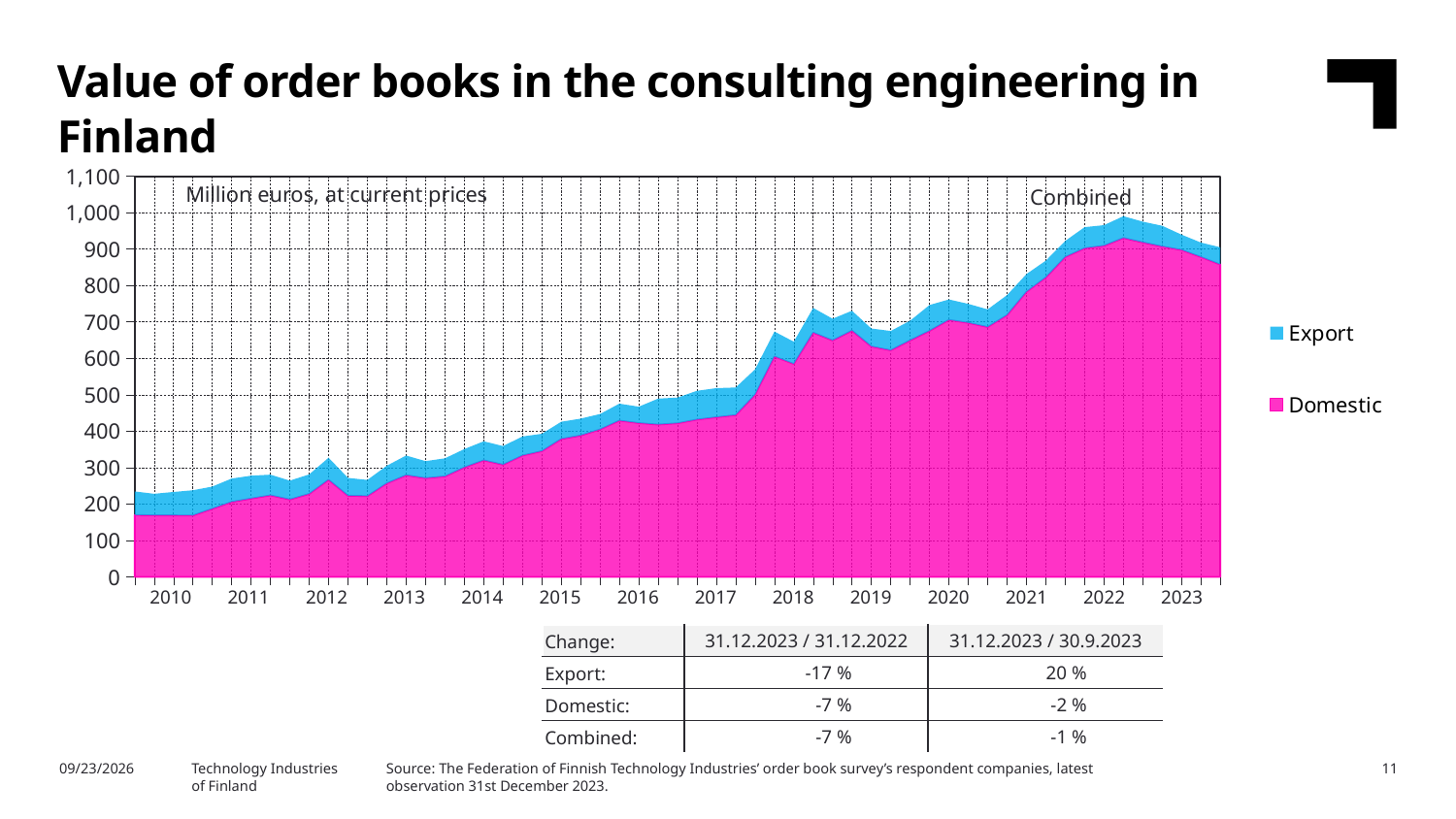
How many years are labelled on the x axis of the chart? 14 Is the Domestic value at the start of 2010 greater or less than 200? less What kind of chart is shown on the slide? Stacked area chart Do the combined order book values generally rise or fall from 2010 to 2022? Rise Which two series are listed in the chart legend? Export and Domestic Is the combined value at the start of 2016 greater or less than 400? greater Is the combined value at the start of 2010 greater or less than 300? less How many series does the chart legend list? 2 In which year does the combined value of order books reach its highest point? 2022 According to the change table below the chart, what is the Export change for 31.12.2023 / 31.12.2022? -17 % What unit is stated in the chart for the values plotted? Million euros, at current prices